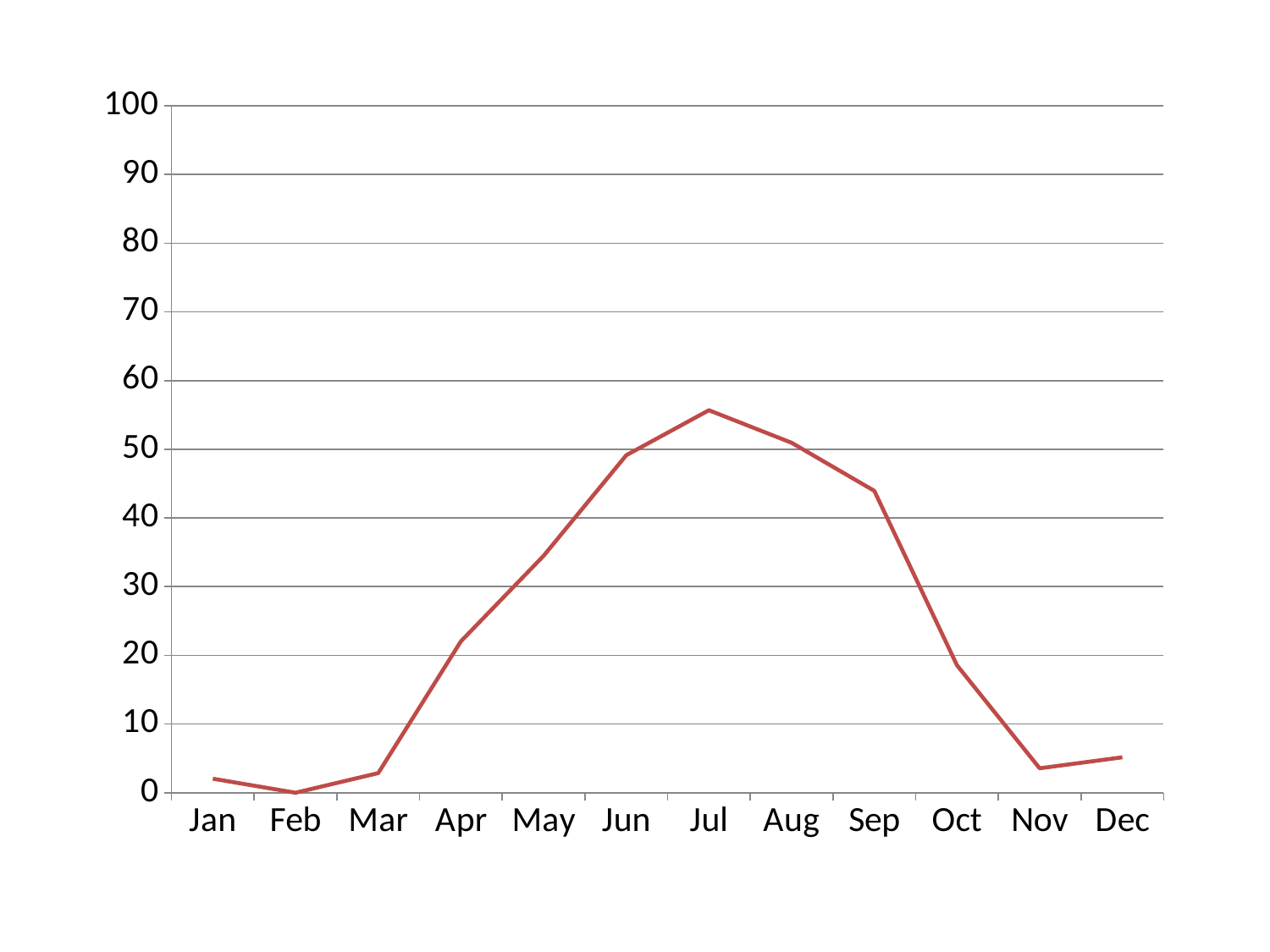
What kind of chart is shown on the slide? line chart Is the value for Sep greater or less than 50? less Is the value for Apr greater or less than 30? less Is the value for Jul greater or less than 50? greater Do the values rise or fall from Jul to Nov? fall Do the values rise or fall from Mar to Jul? rise Which is larger, the value for May or the value for Aug? Aug Which is larger, the value for Jun or the value for Oct? Jun Which month has the highest value? Jul How many months are plotted along the x axis? 12 Which month has the lowest value? Feb